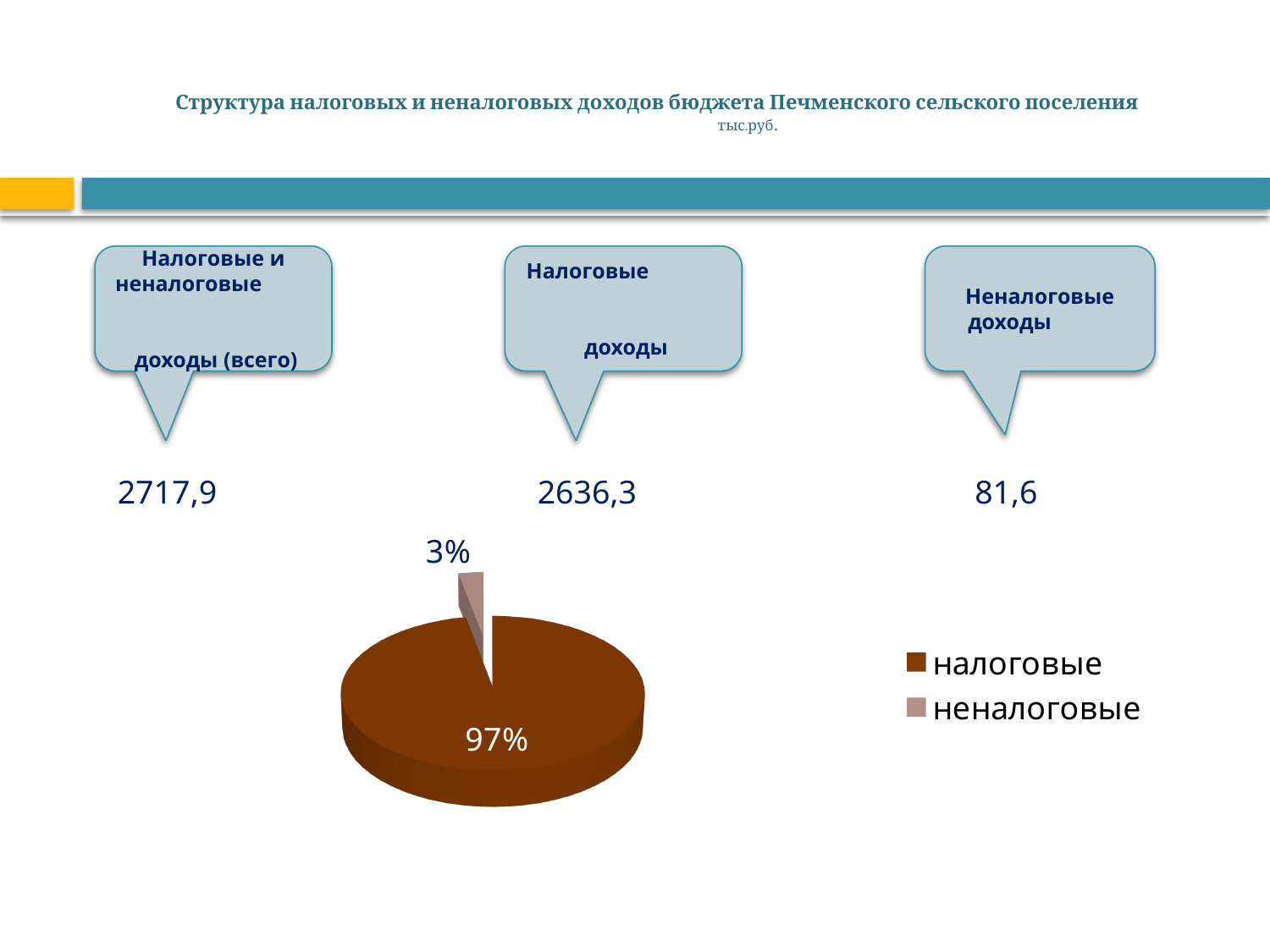
Which is larger in the pie chart, "налоговые" or "неналоговые"? налоговые Which slice of the pie chart is the largest? налоговые What colour is the "налоговые" slice in the pie chart? brown What are the two legend entries of the pie chart? налоговые, неналоговые How many slices does the pie chart have? 2 Which slice of the pie chart is the smallest? неналоговые What share of the pie does the "неналоговые" slice represent? 3% How many entries does the legend of the pie chart list? 2 What share of the pie does the "налоговые" slice represent? 97% What kind of chart is shown on the slide? pie chart By how many percentage points does the "налоговые" share exceed the "неналоговые" share in the pie chart? 94%